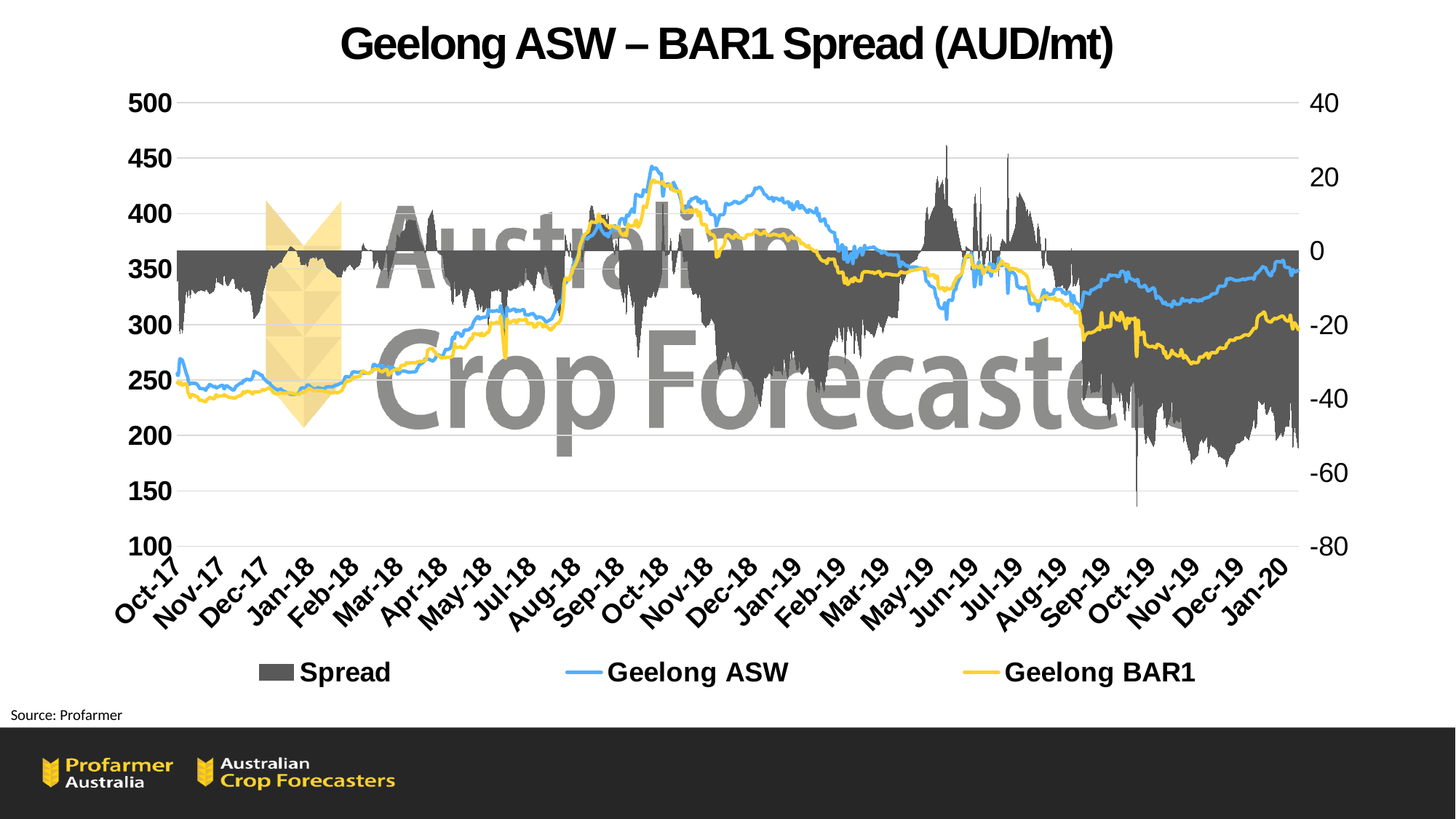
Does the Geelong BAR1 line rise or fall between Oct-18 and Nov-19? fall Around which month does the Geelong ASW line reach its highest point? Oct-18 Is the value for Geelong BAR1 around Nov-17 greater or less than 250? less How many series does the legend list? 3 Does the Geelong ASW line rise or fall between Oct-17 and Oct-18? rise Is the value for Geelong BAR1 around Nov-19 greater or less than 300? less What are the three series named in the legend? Spread, Geelong ASW, Geelong BAR1 Around Jan-20, which is higher, Geelong ASW or Geelong BAR1? Geelong ASW What kind of chart is shown on the slide? A line chart with a shaded area series What is the title of the chart? Geelong ASW – BAR1 Spread (AUD/mt) Is the value for Geelong ASW around Oct-18 greater or less than 400? greater